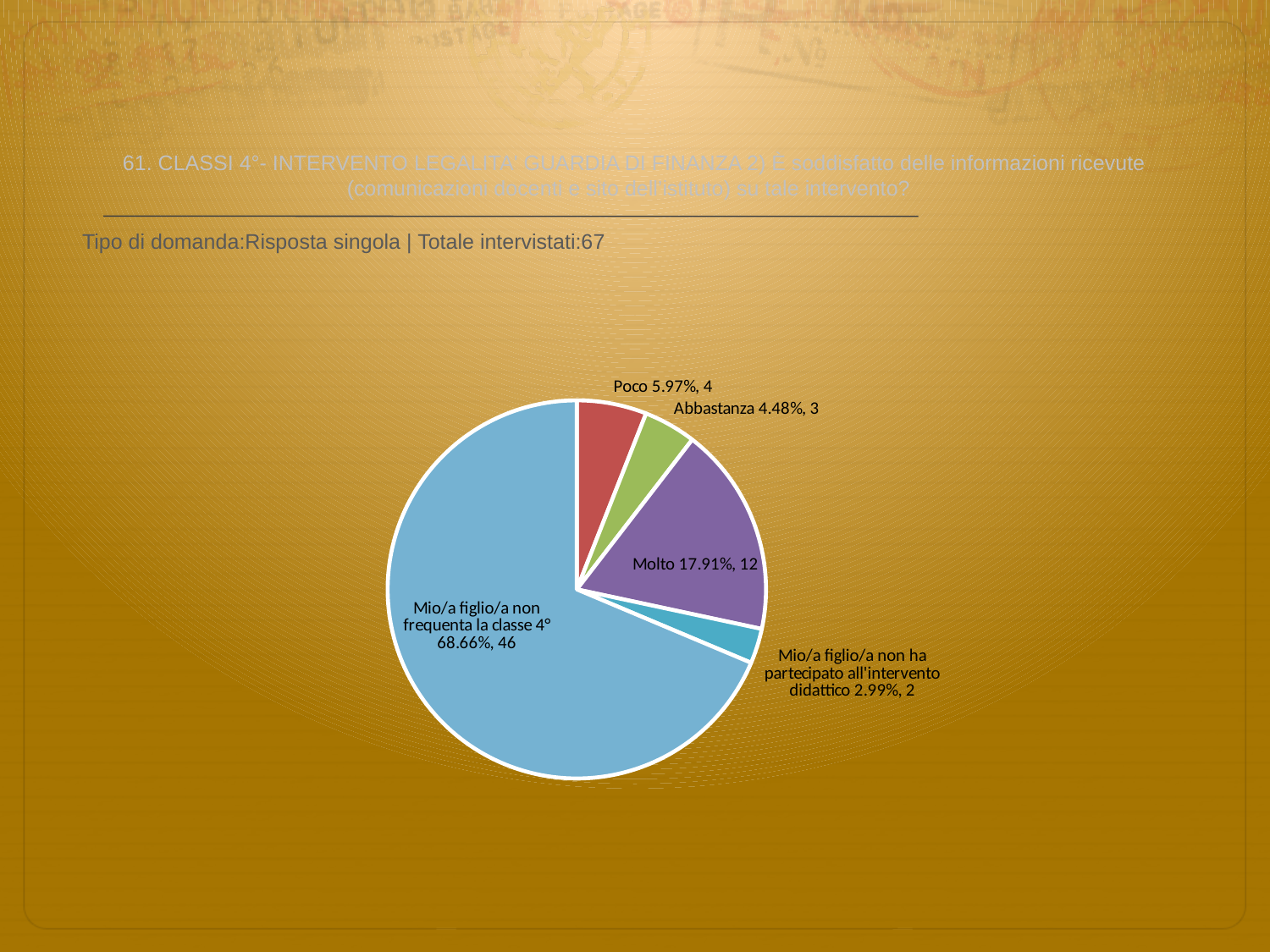
How many respondents answered "Poco"? 4 Which slice is the largest in the pie chart? Mio/a figlio/a non frequenta la classe 4° What is the difference in respondent count between "Molto" and "Abbastanza"? 9 How many respondents are in the "Mio/a figlio/a non frequenta la classe 4°" slice? 46 What share of the pie does the "Poco" slice represent? 5.97% What percentage is shown for "Abbastanza"? 4.48% What kind of chart is shown on the slide? pie chart What percentage is shown for the "Molto" slice? 17.91% Which has more respondents, "Molto" or "Poco"? Molto How many slices does the pie chart have? 5 Which slice is the smallest in the pie chart? Mio/a figlio/a non ha partecipato all'intervento didattico What percentage is shown for "Mio/a figlio/a non ha partecipato all'intervento didattico"? 2.99%